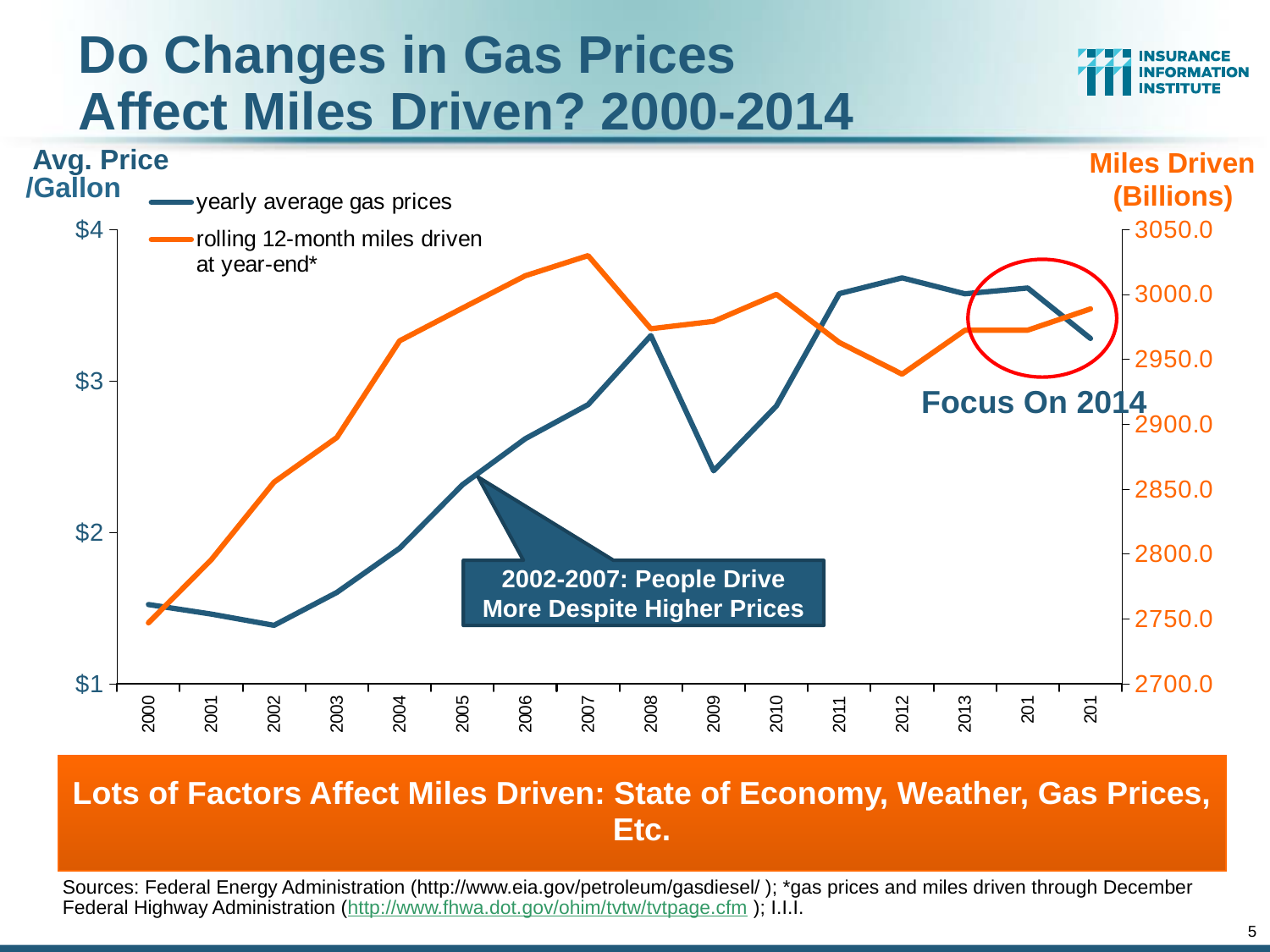
Do yearly average gas prices rise or fall from 2002 to 2008? rise How many series does the legend list? 2 What kind of chart is shown on the slide? line chart In which year is the rolling 12-month miles driven value highest? 2007 Which year has the higher yearly average gas price, 2009 or 2012? 2012 Is the yearly average gas price for 2002 greater or less than $2? less Is the rolling 12-month miles driven value for 2000 greater or less than 2800.0? less Is the yearly average gas price for 2008 greater or less than $3? greater In which year is the rolling 12-month miles driven value lowest? 2000 In which year is the yearly average gas price lowest? 2002